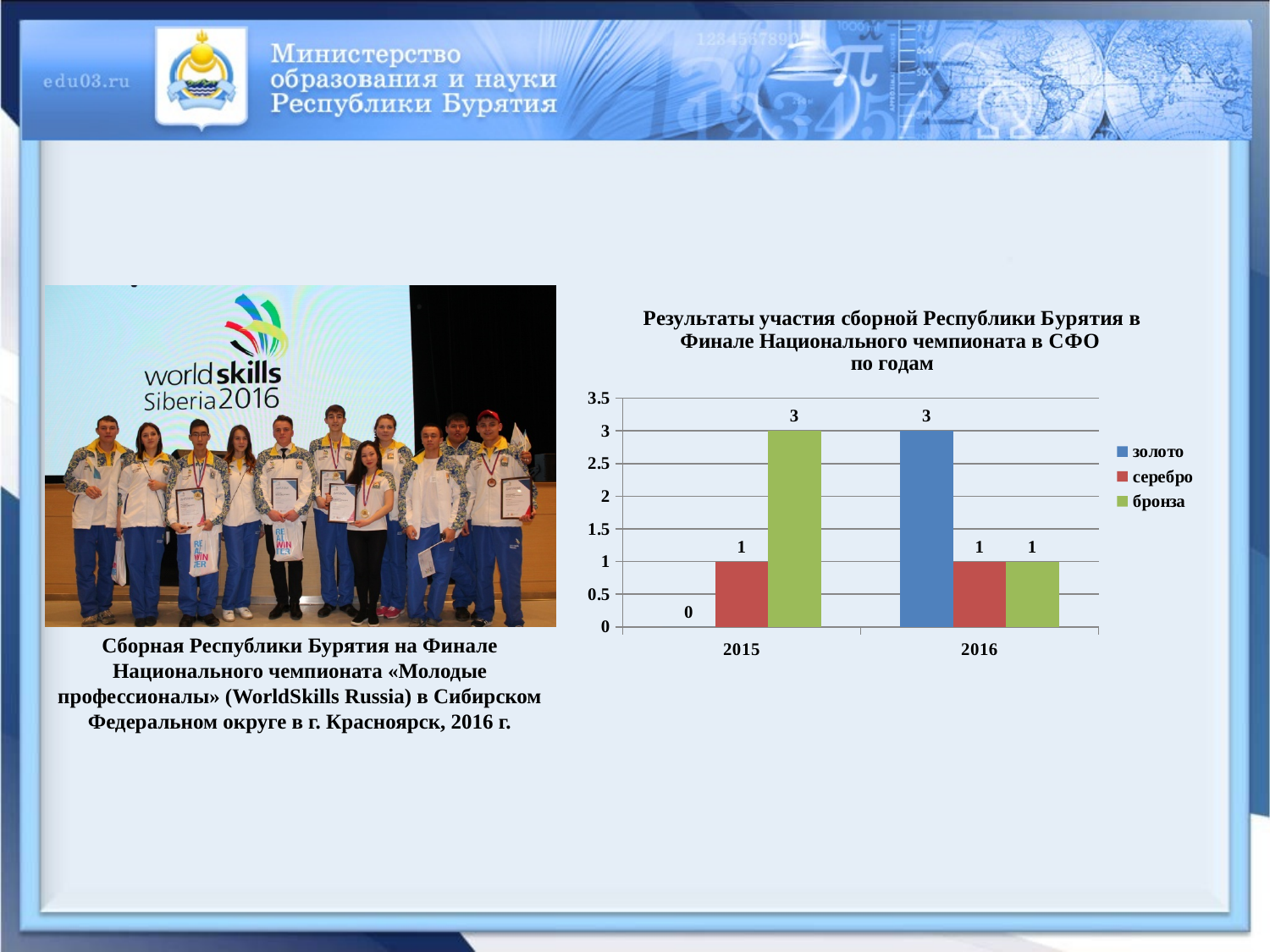
What is the value for бронза in 2015? 3 Which is larger: бронза in 2015 or бронза in 2016? бронза in 2015 How many series does the chart legend list? 3 What is the value for золото in 2016? 3 Which series has the highest value in 2015? бронза How many years (categories) are shown on the x axis of the chart? 2 What kind of chart is shown on the slide? bar chart What is the value for золото in 2015? 0 Which series has the lowest value in 2016? серебро and бронза (both 1) Which legend entry is shown in blue? золото What is the value for серебро in 2016? 1 What is the difference between the золото value in 2016 and the золото value in 2015? 3